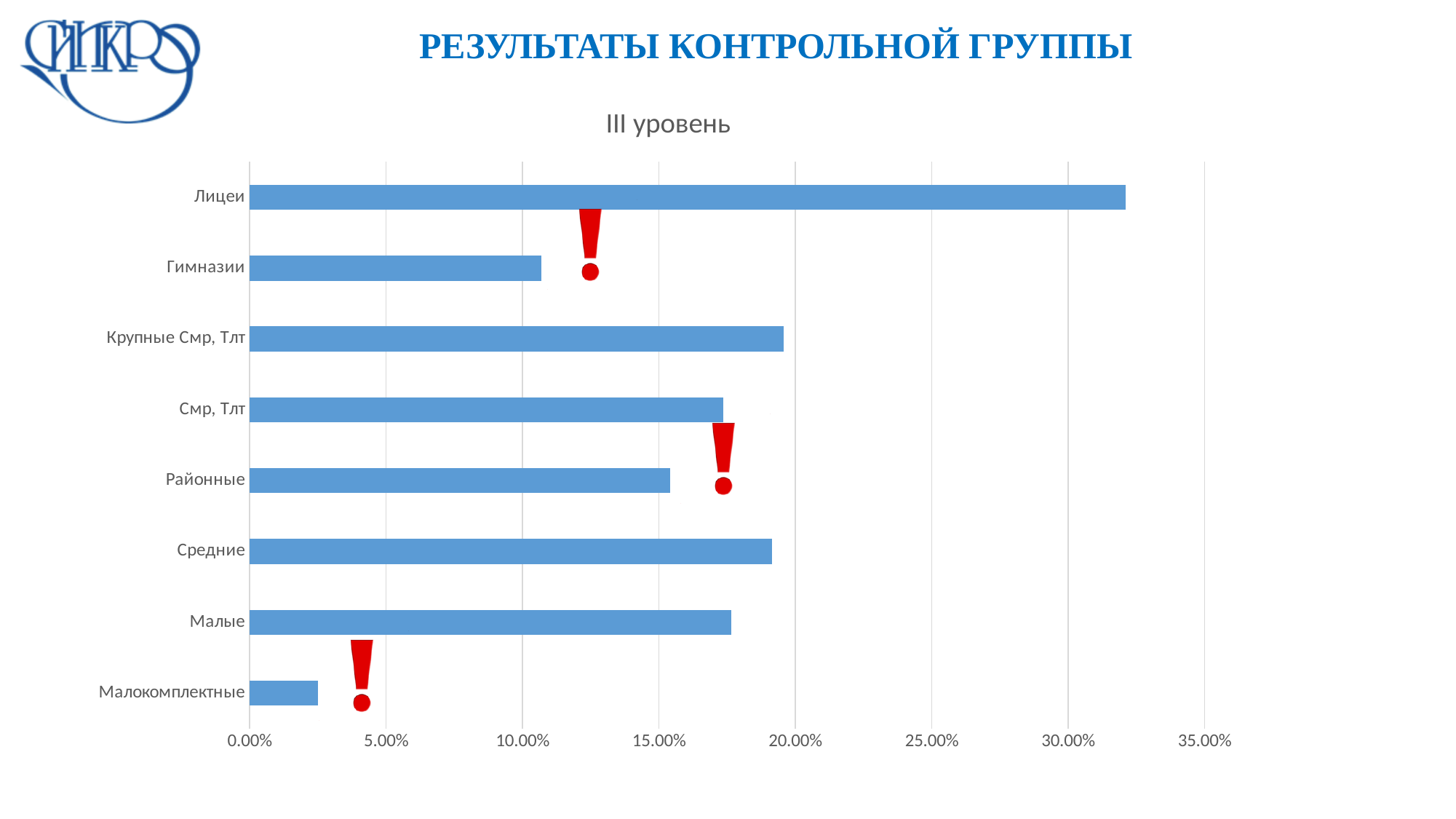
What is the highest value shown on the horizontal axis? 35.00% Which category has the highest value? Лицеи How many categories are plotted in the chart? 8 What is the title of the chart? III уровень Which category has the lowest value? Малокомплектные What kind of chart is shown on the slide? bar chart Is the value for Лицеи greater or less than 30.00%? greater Is the value for Крупные Смр, Тлт greater or less than 20.00%? less Is the value for Гимназии greater or less than 15.00%? less Which is larger, the value for Крупные Смр, Тлт or the value for Районные? Крупные Смр, Тлт Which is larger, the value for Лицеи or the value for Гимназии? Лицеи